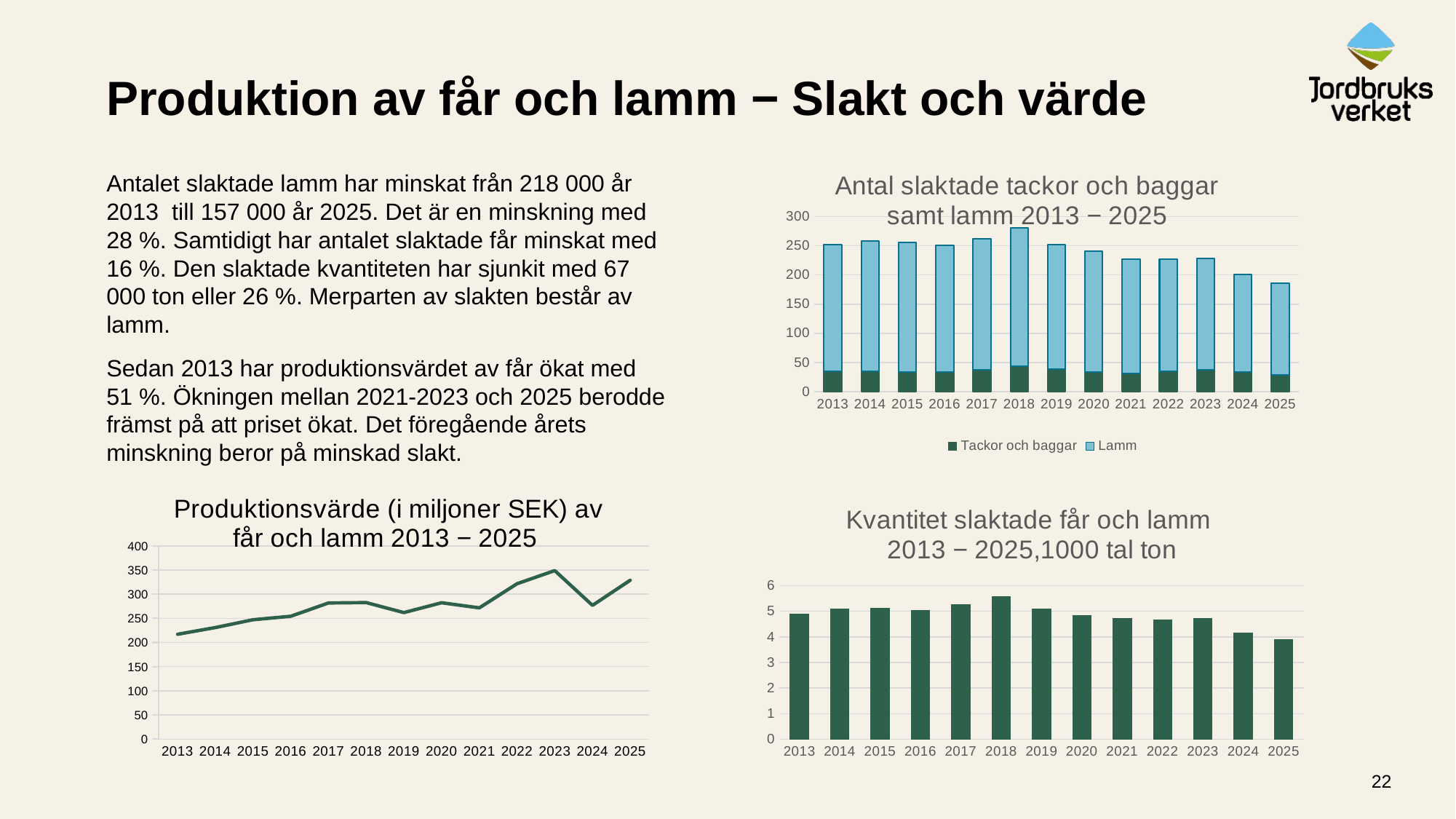
In the chart 'Produktionsvärde (i miljoner SEK) av får och lamm 2013 − 2025', is the value for 2023 greater or less than 300? greater In the chart 'Produktionsvärde (i miljoner SEK) av får och lamm 2013 − 2025', do the values generally rise or fall from 2013 to 2025? rise In the chart 'Produktionsvärde (i miljoner SEK) av får och lamm 2013 − 2025', which year has the lowest value? 2013 In the chart 'Produktionsvärde (i miljoner SEK) av får och lamm 2013 − 2025', which year has the highest value? 2023 In the chart 'Antal slaktade tackor och baggar samt lamm 2013 − 2025', which year has the tallest stacked bar? 2018 How many series does the legend of the chart 'Antal slaktade tackor och baggar samt lamm 2013 − 2025' list? 2 In the chart 'Kvantitet slaktade får och lamm 2013 − 2025,1000 tal ton', which year has the highest value? 2018 What kind of chart is 'Produktionsvärde (i miljoner SEK) av får och lamm 2013 − 2025'? line chart In the chart 'Antal slaktade tackor och baggar samt lamm 2013 − 2025', which year has the shortest stacked bar? 2025 In the chart 'Antal slaktade tackor och baggar samt lamm 2013 − 2025', which series is shown in light blue? Lamm What kind of chart is 'Kvantitet slaktade får och lamm 2013 − 2025,1000 tal ton'? bar chart